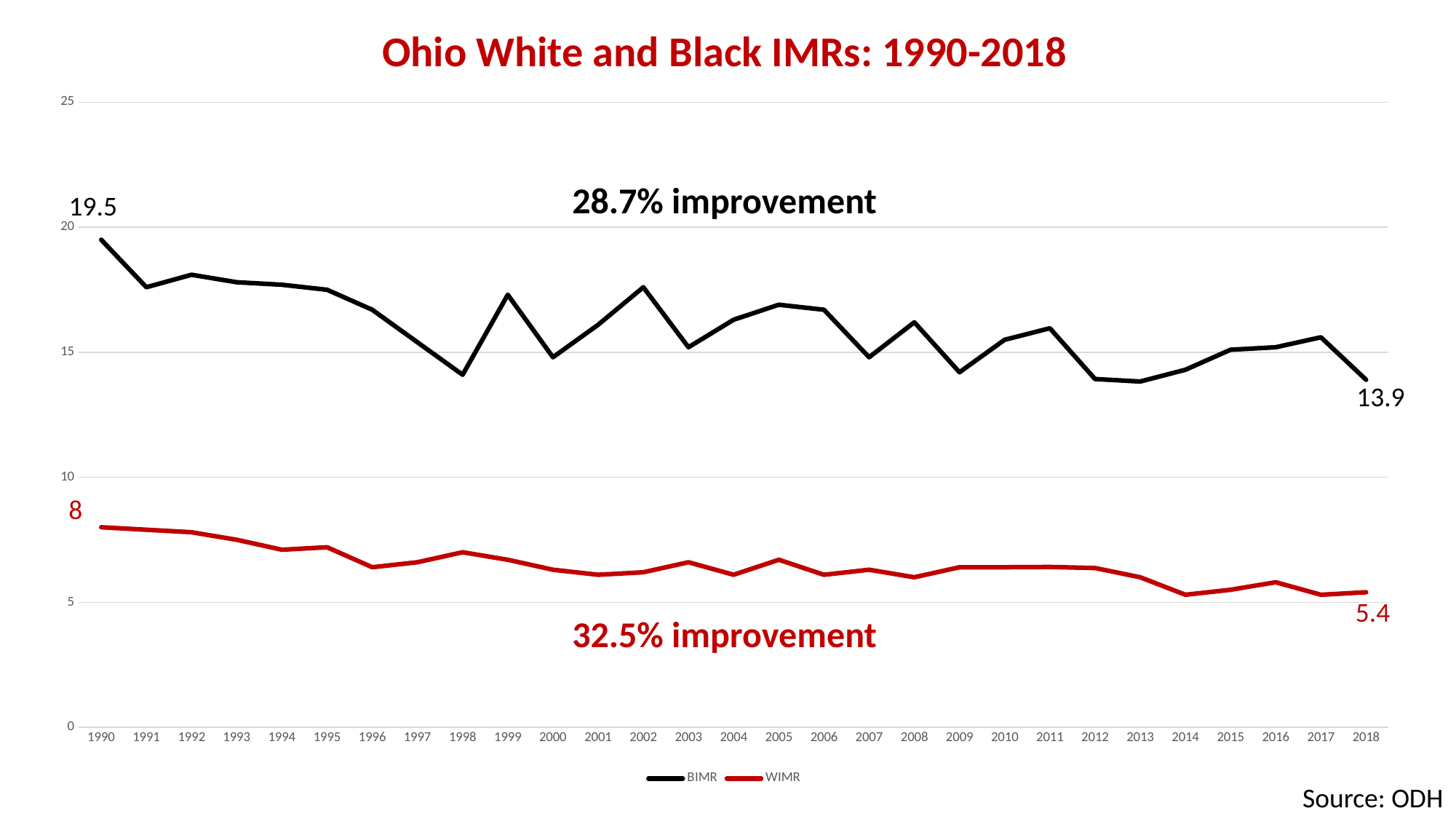
What is the difference between the BIMR and WIMR values in 2018? 8.5 What is the WIMR value for 1990? 8 What is the BIMR value for 1990? 19.5 In which year is the BIMR value highest? 1990 Which series has the larger value in 1990, BIMR or WIMR? BIMR How many series does the legend list? 2 What percentage improvement is shown for the WIMR series? 32.5% improvement What kind of chart is shown on the slide? line chart Is the BIMR value for 1998 greater or less than 15? less By how much did the BIMR value fall from 1990 to 2018? 5.6 What is the WIMR value for 2018? 5.4 What is the BIMR value for 2018? 13.9